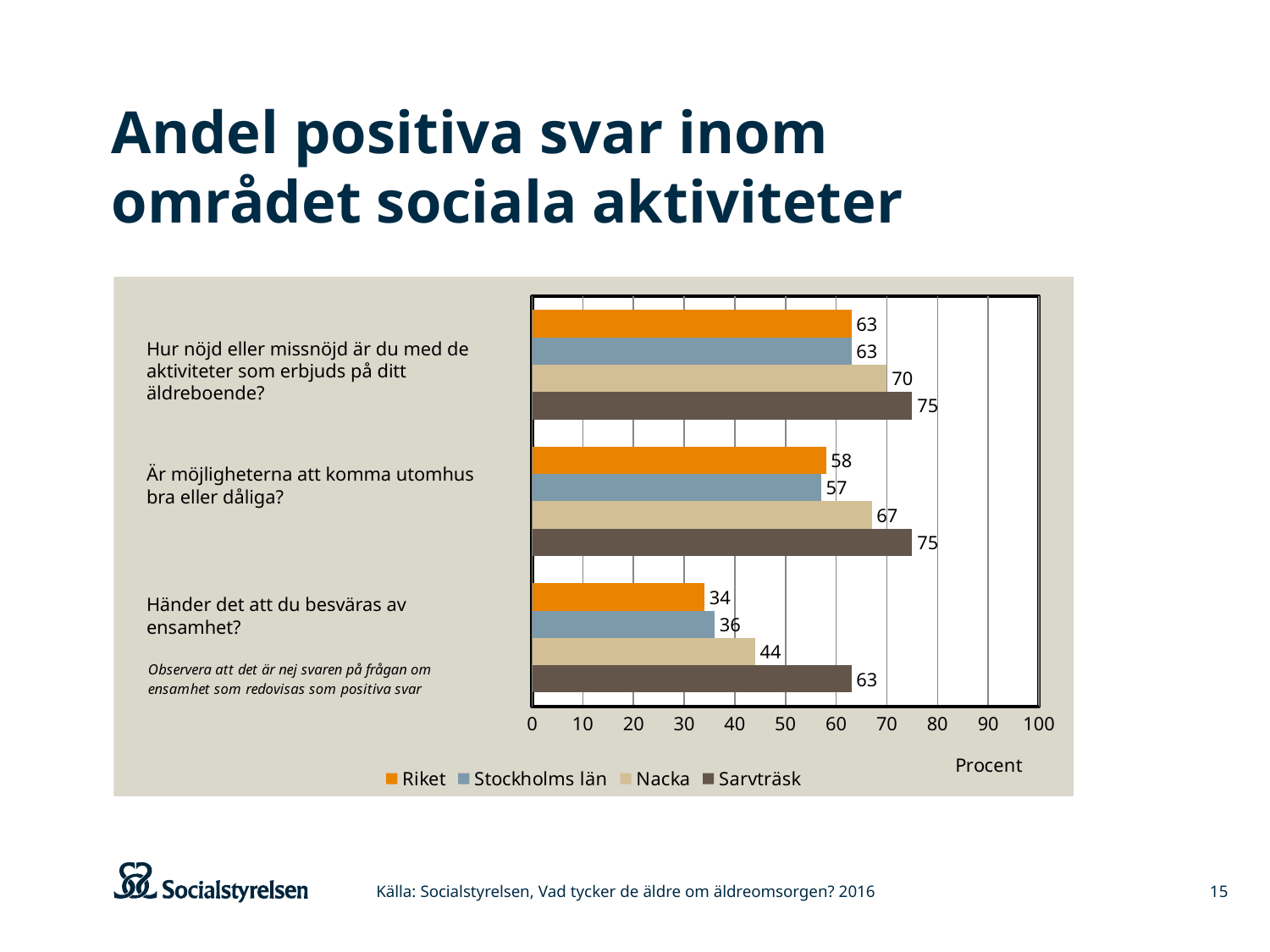
What kind of chart is shown on the slide? Bar chart What is the value for Stockholms län on the question "Är möjligheterna att komma utomhus bra eller dåliga?"? 57 What is the difference between the Sarvträsk and Nacka values on the question "Händer det att du besväras av ensamhet?"? 19 Which series has the highest value on the question "Händer det att du besväras av ensamhet?"? Sarvträsk What unit is shown on the horizontal axis of the chart? Procent What is the value for Sarvträsk on the question "Hur nöjd eller missnöjd är du med de aktiviteter som erbjuds på ditt äldreboende?"? 75 What is the value for Nacka on the question "Är möjligheterna att komma utomhus bra eller dåliga?"? 67 How many series does the legend list? 4 Which series has the lowest value on the question "Händer det att du besväras av ensamhet?"? Riket Which is larger on the question "Är möjligheterna att komma utomhus bra eller dåliga?": the value for Riket or for Nacka? Nacka What is the value for Riket on the question "Händer det att du besväras av ensamhet?"? 34 How many question categories are shown on the chart? 3